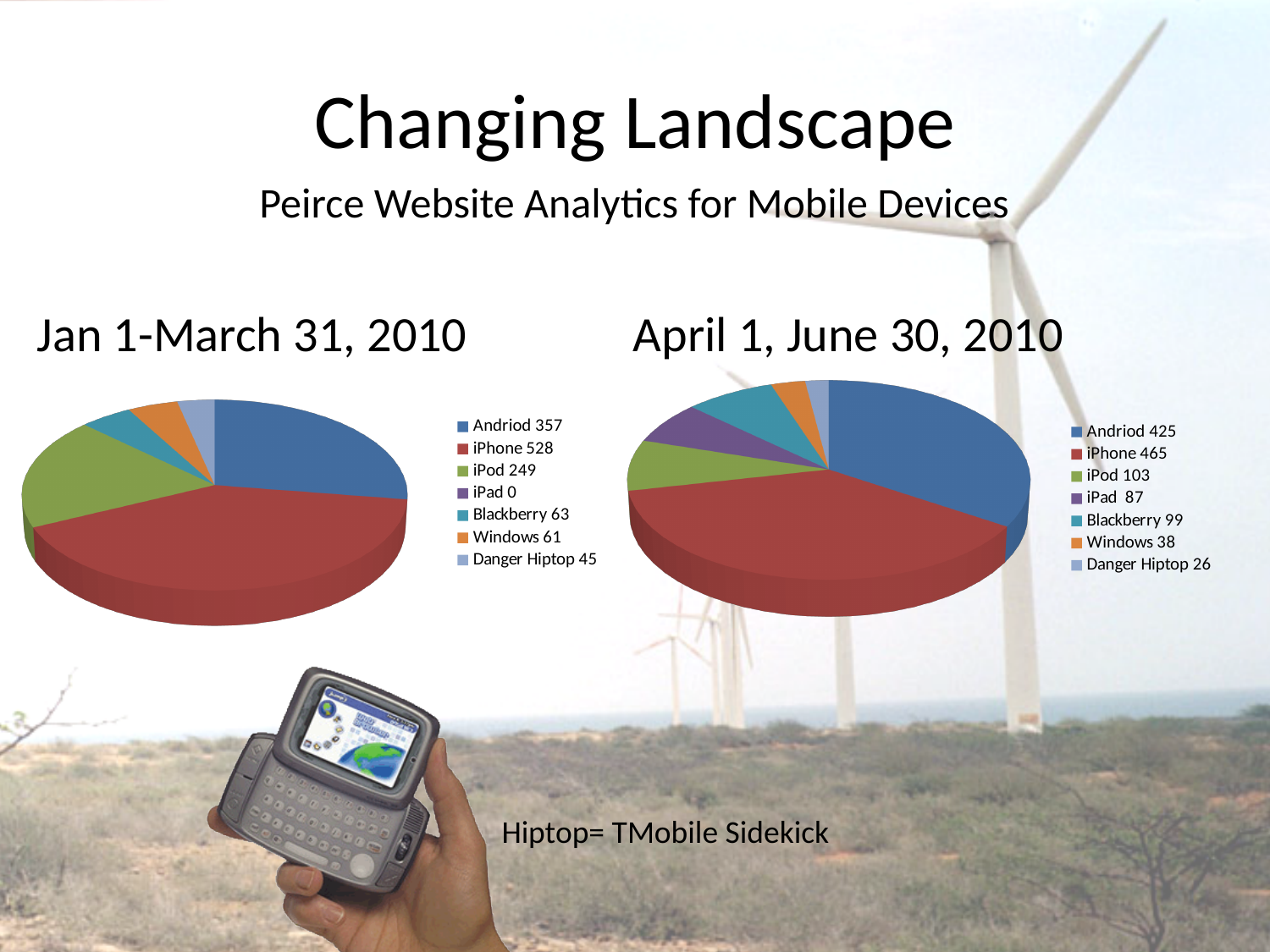
In the Jan 1-March 31, 2010 chart, what is the value for iPhone? 528 What kind of chart is the Jan 1-March 31, 2010 chart? Pie chart In the Jan 1-March 31, 2010 chart, which device has the smallest value? iPad How many categories does the legend of the April 1, June 30, 2010 chart list? 7 In the April 1, June 30, 2010 chart, what is the value for Blackberry? 99 In the April 1, June 30, 2010 chart, what is the value for iPad? 87 In the Jan 1-March 31, 2010 chart, which is larger, Blackberry or Windows? Blackberry In the April 1, June 30, 2010 chart, which device has the smallest value? Danger Hiptop In the Jan 1-March 31, 2010 chart, what is the difference between the Andriod and iPod values? 108 In the Jan 1-March 31, 2010 chart, which device has the largest value? iPhone In the April 1, June 30, 2010 chart, what colour is the iPhone slice? Red In the April 1, June 30, 2010 chart, what is the difference between the iPhone and Andriod values? 40